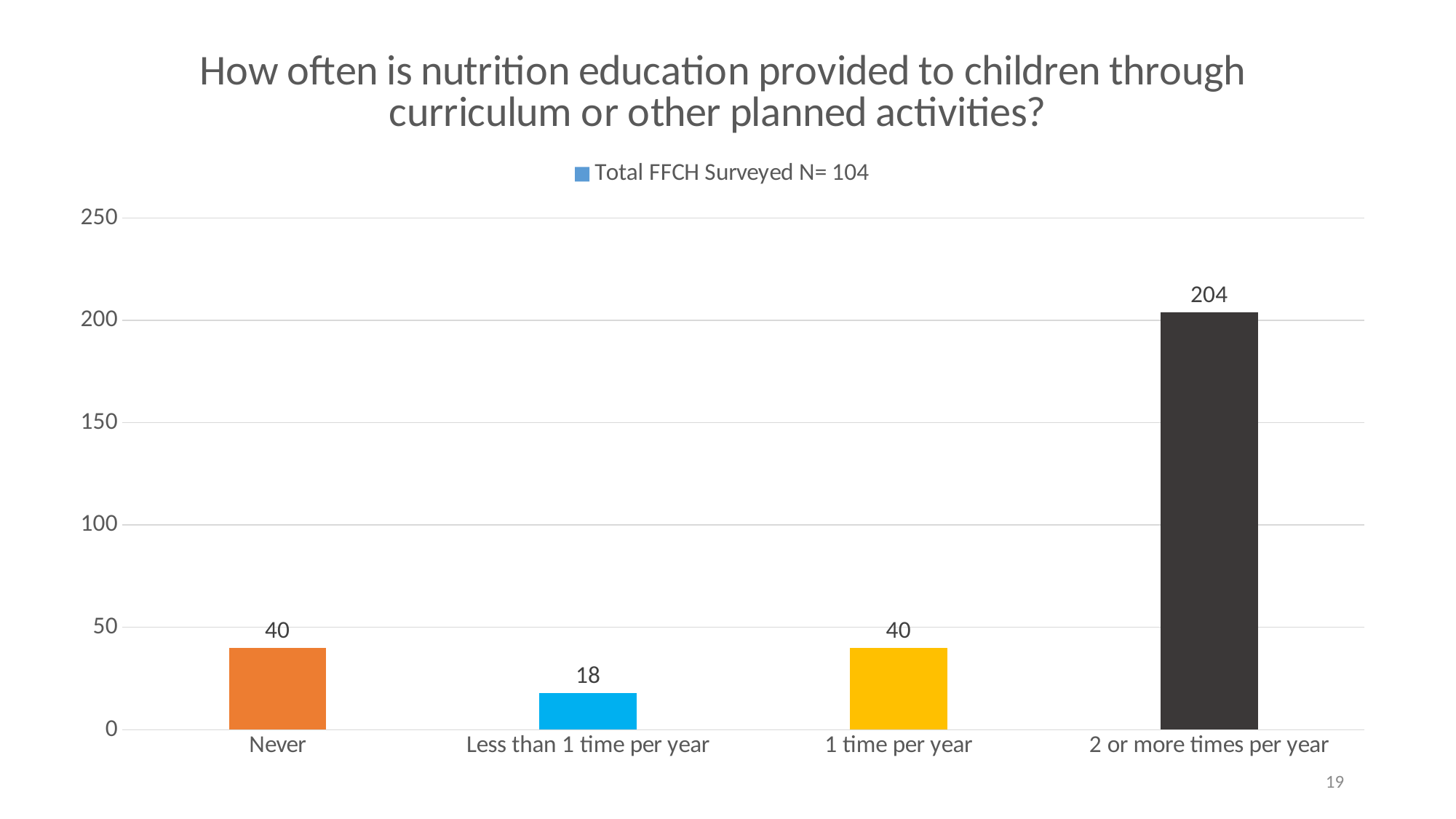
What is the legend entry shown above the chart? Total FFCH Surveyed N= 104 What is the value for "2 or more times per year"? 204 What is the difference between the values for "2 or more times per year" and "Never"? 164 What kind of chart is shown on the slide? bar chart Which category has the lowest value? Less than 1 time per year What is the value for "Less than 1 time per year"? 18 What is the difference between the values for "1 time per year" and "Less than 1 time per year"? 22 How many categories are shown on the x axis? 4 Which is larger, the value for "Never" or the value for "Less than 1 time per year"? Never Which category has the highest value? 2 or more times per year What is the value for "Never"? 40 Is the value for "2 or more times per year" greater or less than 200? greater